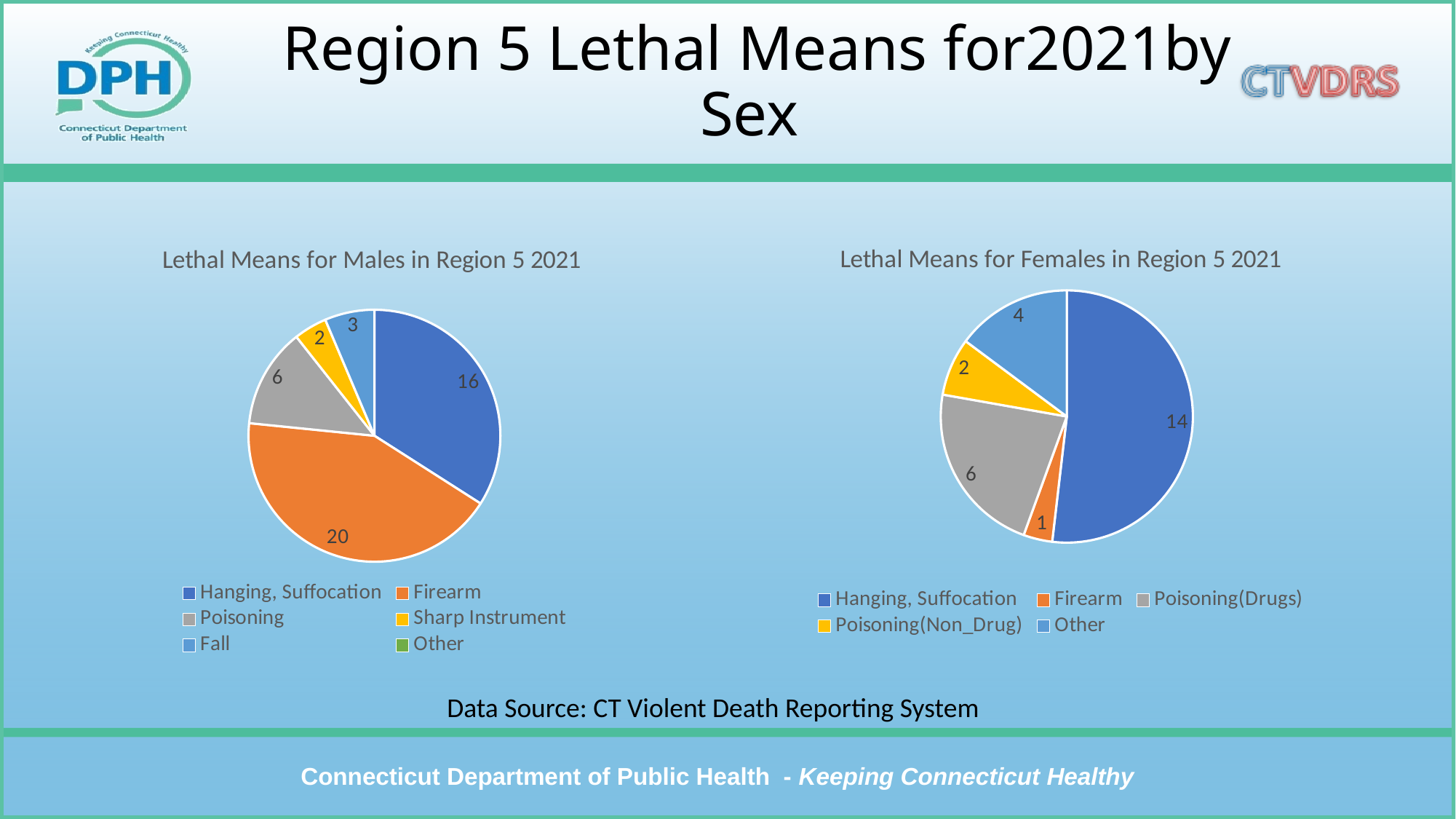
In the Lethal Means for Males in Region 5 2021 chart, what is the value for Poisoning? 6 In the Lethal Means for Males in Region 5 2021 chart, what is the difference between Firearm and Hanging, Suffocation? 4 In the Lethal Means for Females in Region 5 2021 chart, what is the value for Other? 4 How many entries does the legend of the Lethal Means for Females in Region 5 2021 chart list? 5 In the Lethal Means for Males in Region 5 2021 chart, which is larger, Fall or Sharp Instrument? Fall In the Lethal Means for Females in Region 5 2021 chart, which category has the smallest slice? Firearm How many entries does the legend of the Lethal Means for Males in Region 5 2021 chart list? 6 What type of chart is the Lethal Means for Females in Region 5 2021 chart? Pie chart In the Lethal Means for Females in Region 5 2021 chart, what is the difference between Poisoning(Drugs) and Poisoning(Non_Drug)? 4 In the Lethal Means for Females in Region 5 2021 chart, what is the value for Hanging, Suffocation? 14 In the Lethal Means for Males in Region 5 2021 chart, which category has the largest slice? Firearm In the Lethal Means for Males in Region 5 2021 chart, what is the value for Firearm? 20